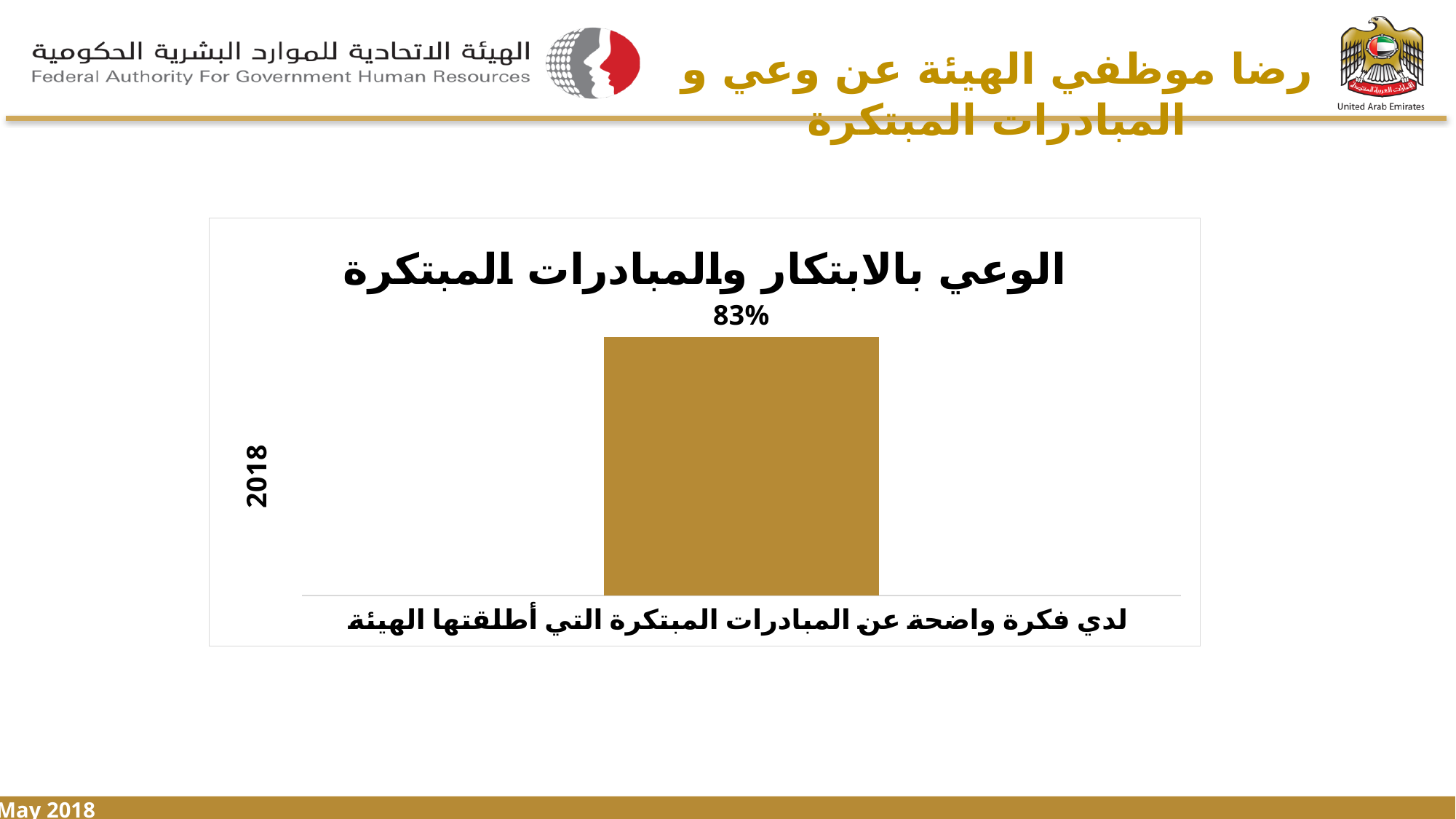
What value is shown for the bar labelled "لدي فكرة واضحة عن المبادرات المبتكرة التي أطلقتها الهيئة"? 83% What is the title of the chart? الوعي بالابتكار والمبادرات المبتكرة What label appears on the vertical axis of the chart? 2018 What kind of chart is shown on the slide? Bar chart How many bars are plotted in the chart? 1 What is the value of the single bar in the chart? 83%